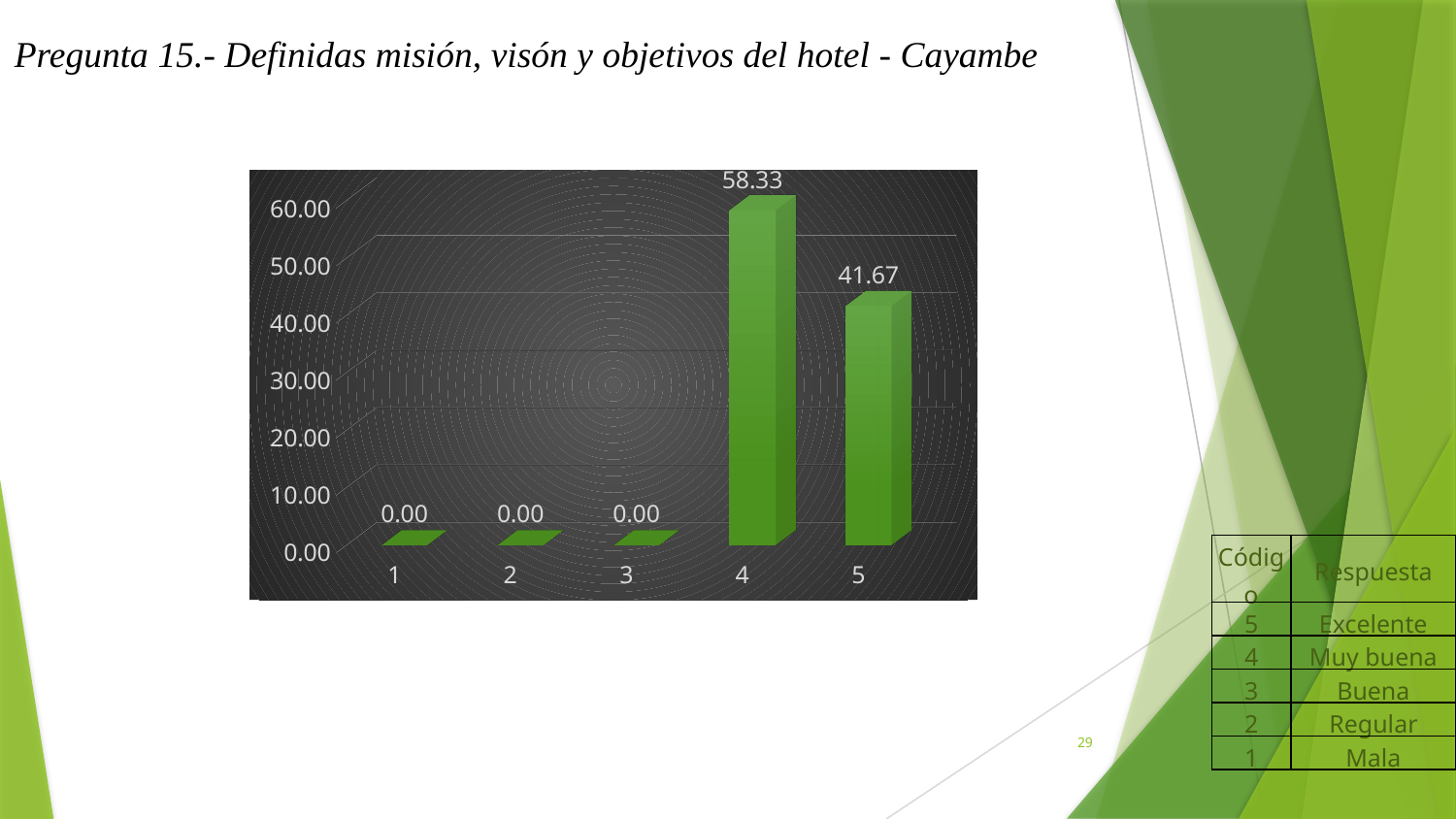
Which is larger, the value for category 4 or the value for category 5? 4 What is the highest tick value shown on the y axis? 60.00 Is the value for category 5 greater or less than 40.00? greater Is the value for category 4 greater or less than 50.00? greater How many categories have a value of 0.00? 3 What is the value for category 5? 41.67 What is the difference between the values for categories 4 and 5? 16.66 What kind of chart is shown on the slide? bar chart Which category has the highest value? 4 What is the value for category 1? 0.00 How many categories are shown on the x axis? 5 What is the value for category 4? 58.33